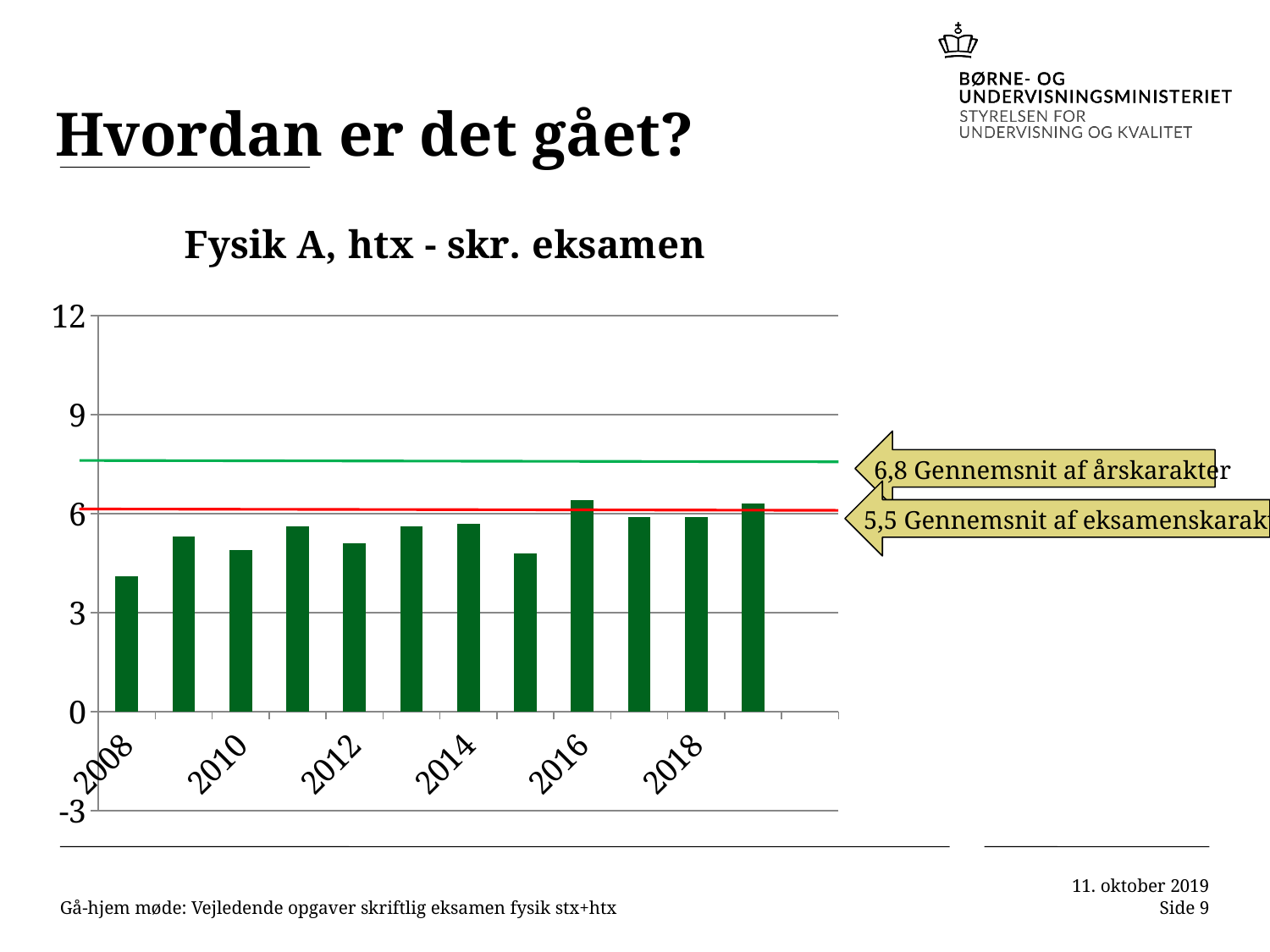
Is the value for 2016 greater or less than 6? greater Is the value for 2008 greater or less than 6? less What value does the annotation give for 'Gennemsnit af årskarakter'? 6,8 How many bars are plotted in the chart? 12 Which year has the lowest bar in the chart? 2008 Do the bar values generally rise or fall from 2008 to 2019? rise What kind of chart is shown on the slide? bar chart Which is larger, the value for 2008 or the value for 2016? 2016 What is the highest value shown on the vertical axis? 12 Is the value for 2008 greater or less than 3? greater What is the title of the chart? Fysik A, htx - skr. eksamen